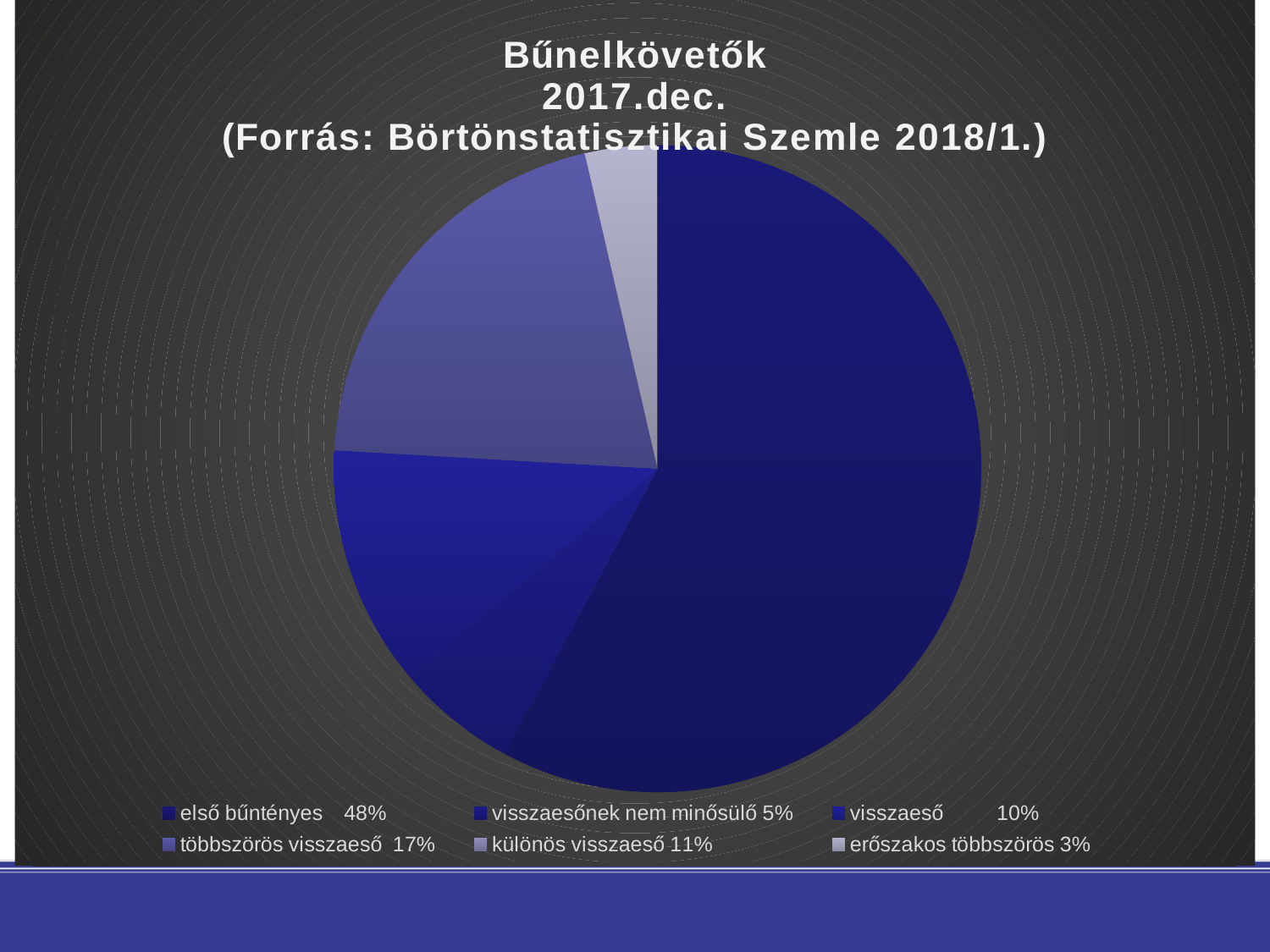
According to the chart title, what is the source of the data? Börtönstatisztikai Szemle 2018/1. What is the difference in percentage points between 'visszaeső' and 'erőszakos többszörös'? 7 What is the difference in percentage points between 'első bűntényes' and 'többszörös visszaeső'? 31 What percentage is shown for 'többszörös visszaeső'? 17% How many categories does the pie chart have? 6 Which is larger: 'visszaeső' or 'különös visszaeső'? különös visszaeső What percentage is shown for 'visszaesőnek nem minősülő'? 5% What kind of chart is shown on the slide? pie chart What percentage is shown for 'első bűntényes'? 48% Which category has the largest share of the pie? első bűntényes Which category has the smallest share of the pie? erőszakos többszörös What percentage is shown for 'különös visszaeső'? 11%